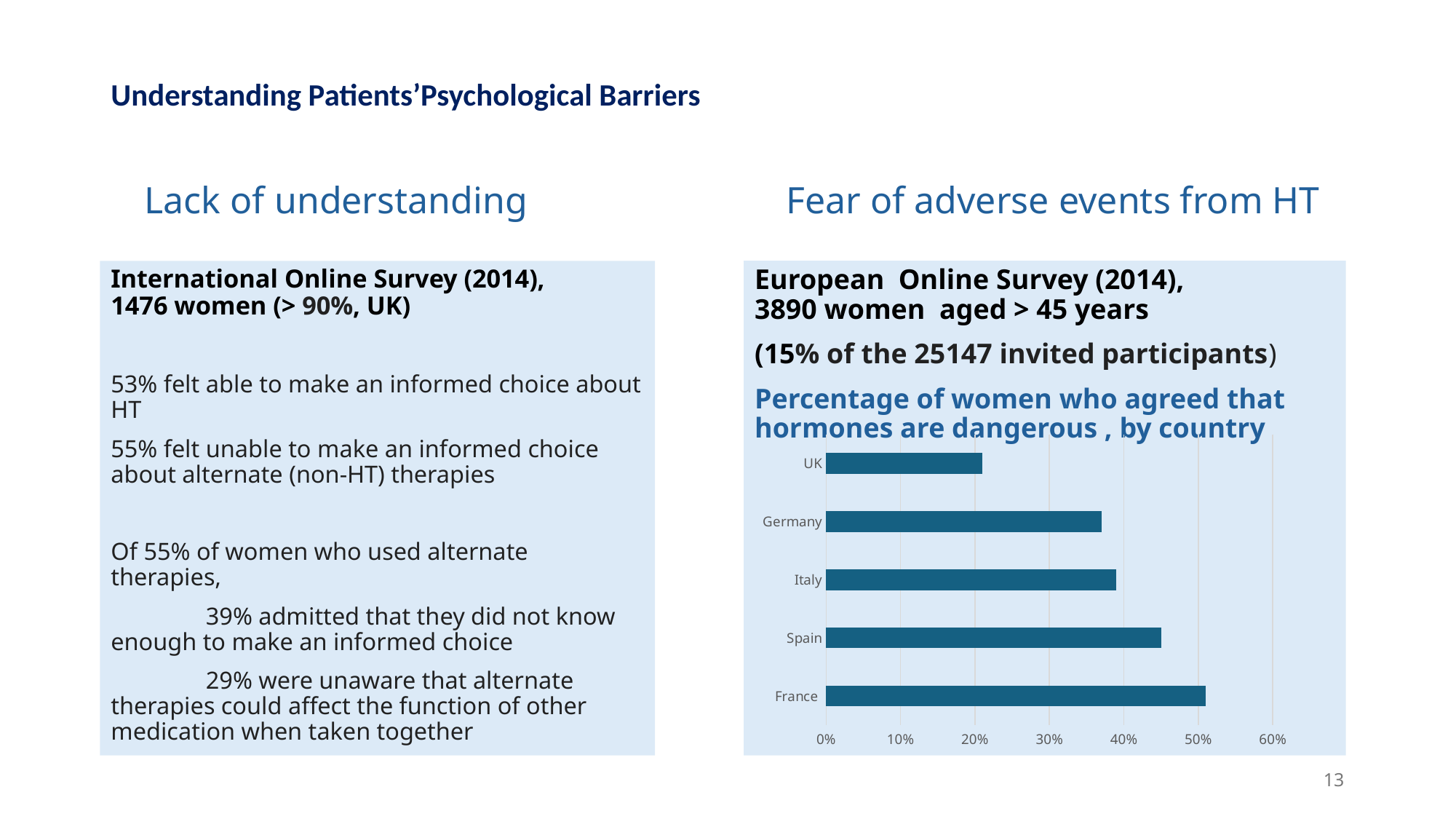
Is the value for the UK greater or less than 30%? less Which has a larger value, France or the UK? France Is the value for Italy greater or less than 30%? greater Which has a larger value, Spain or Germany? Spain Is the value for France greater or less than 40%? greater Which country has the highest percentage of women who agreed that hormones are dangerous? France How many countries are shown in the chart? 5 What kind of chart is shown on the slide? bar chart Which country has the lowest percentage of women who agreed that hormones are dangerous? UK What is the title of the chart? Percentage of women who agreed that hormones are dangerous, by country